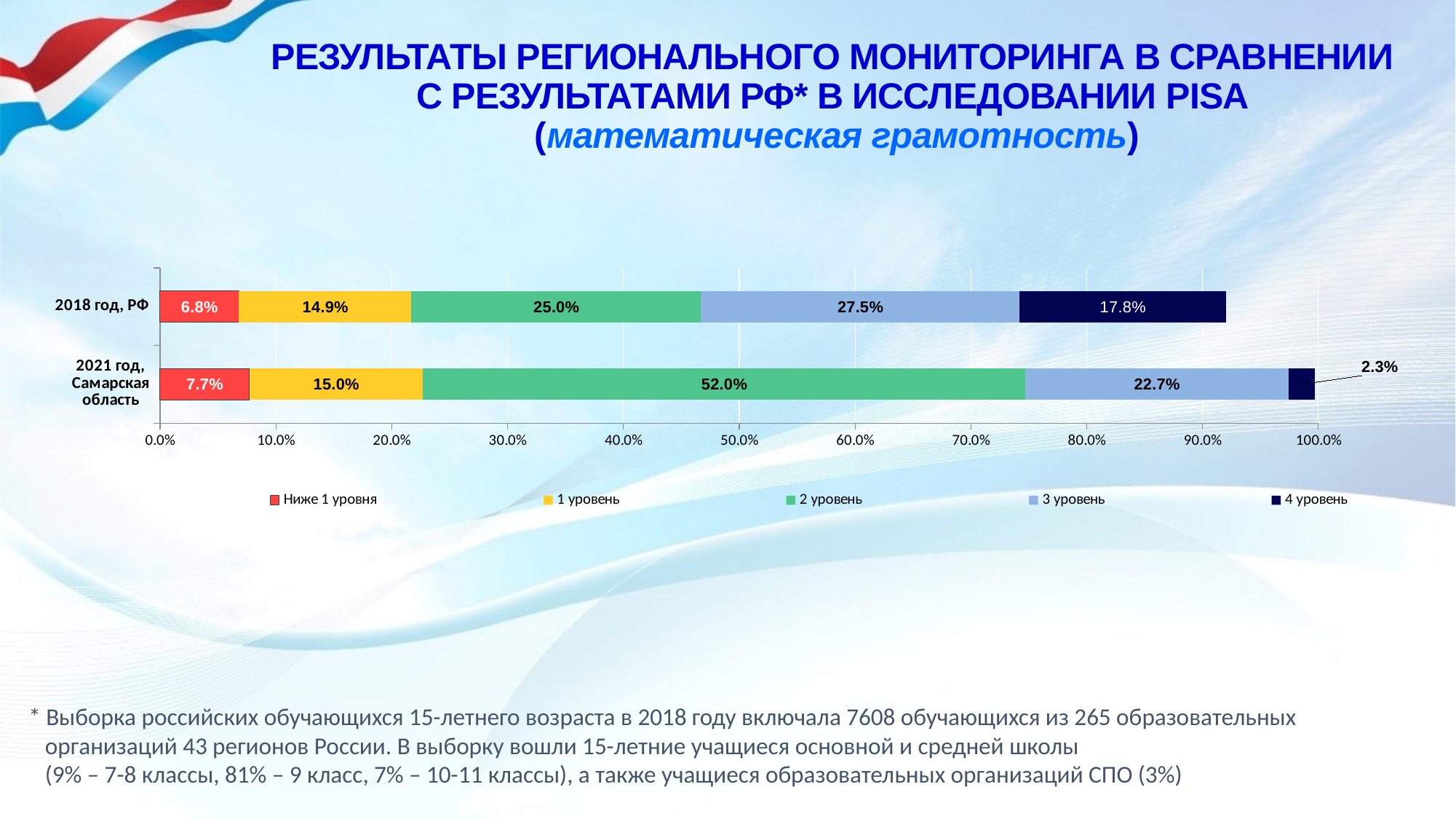
What is the total of the stacked bar for "2018 год, РФ"? 92.0% What is the value of "4 уровень" for "2018 год, РФ"? 17.8% Which level has the largest share in the "2021 год, Самарская область" bar? 2 уровень What is the value of "Ниже 1 уровня" for "2021 год, Самарская область"? 7.7% Which level has the smallest share in the "2018 год, РФ" bar? Ниже 1 уровня What kind of chart is shown on the slide? Stacked bar chart Which is larger: the "4 уровень" value for "2018 год, РФ" or for "2021 год, Самарская область"? 2018 год, РФ What is the value of "3 уровень" for "2018 год, РФ"? 27.5% What is the difference between the "2 уровень" values for "2021 год, Самарская область" and "2018 год, РФ"? 27.0% What is the value of "2 уровень" for "2021 год, Самарская область"? 52.0% How many categories (bars) are shown in the chart? 2 How many series does the legend list? 5